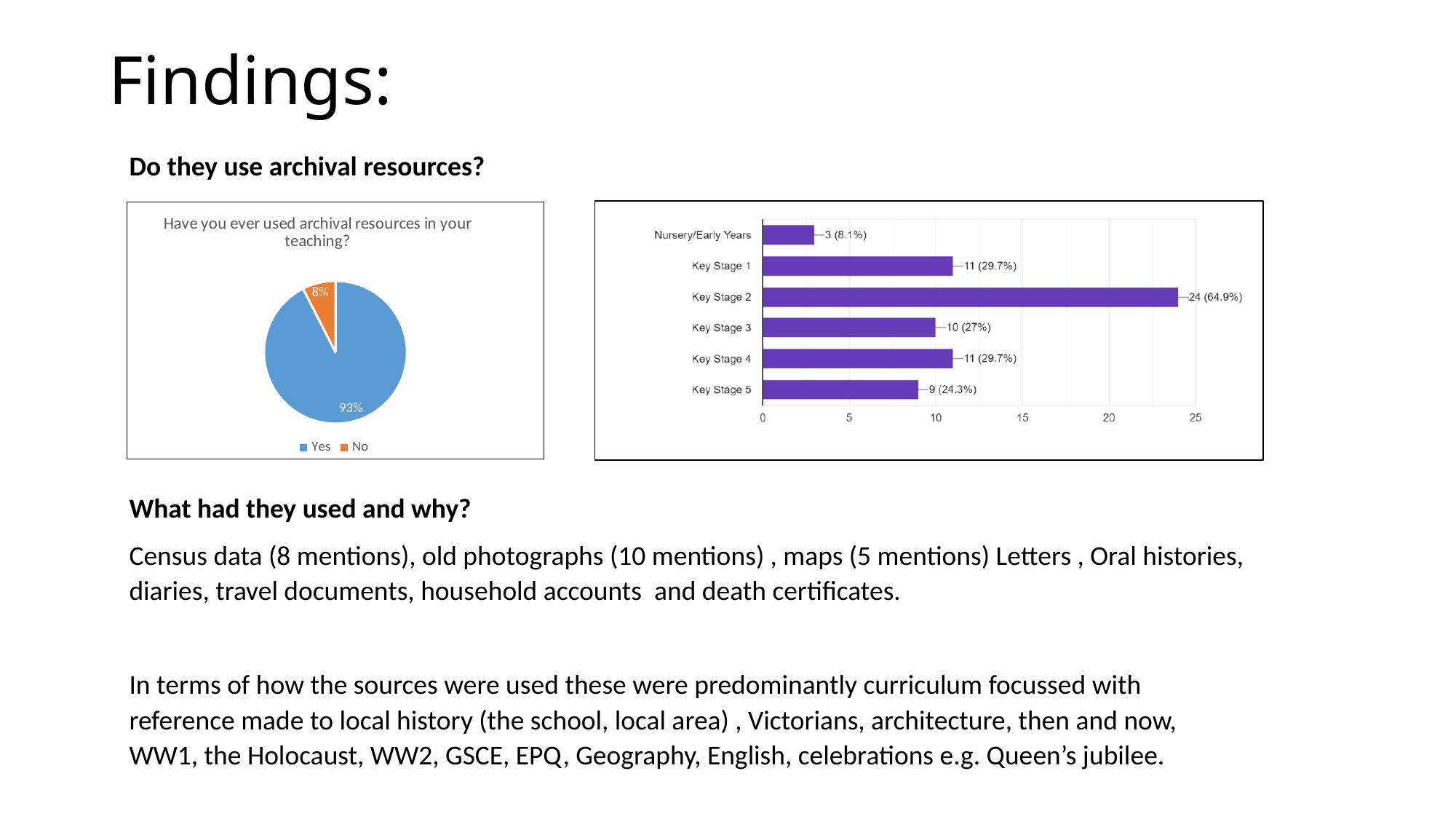
In the pie chart on the left, which response has the larger share, Yes or No? Yes In the pie chart titled "Have you ever used archival resources in your teaching?", what percentage answered Yes? 93% In the pie chart titled "Have you ever used archival resources in your teaching?", what percentage answered No? 8% In the bar chart on the right, what is the value for Key Stage 2? 24 (64.9%) In the bar chart on the right, what is the difference between the counts for Key Stage 2 and Key Stage 5? 15 How many categories are shown in the bar chart on the right? 6 How many entries does the legend of the pie chart on the left list? 2 In the bar chart on the right, which category has the highest value? Key Stage 2 In the bar chart on the right, which category has the lowest value? Nursery/Early Years What kind of chart is the chart on the left of the slide? Pie chart What kind of chart is the chart on the right of the slide? Bar chart In the bar chart on the right, what is the value for Nursery/Early Years? 3 (8.1%)